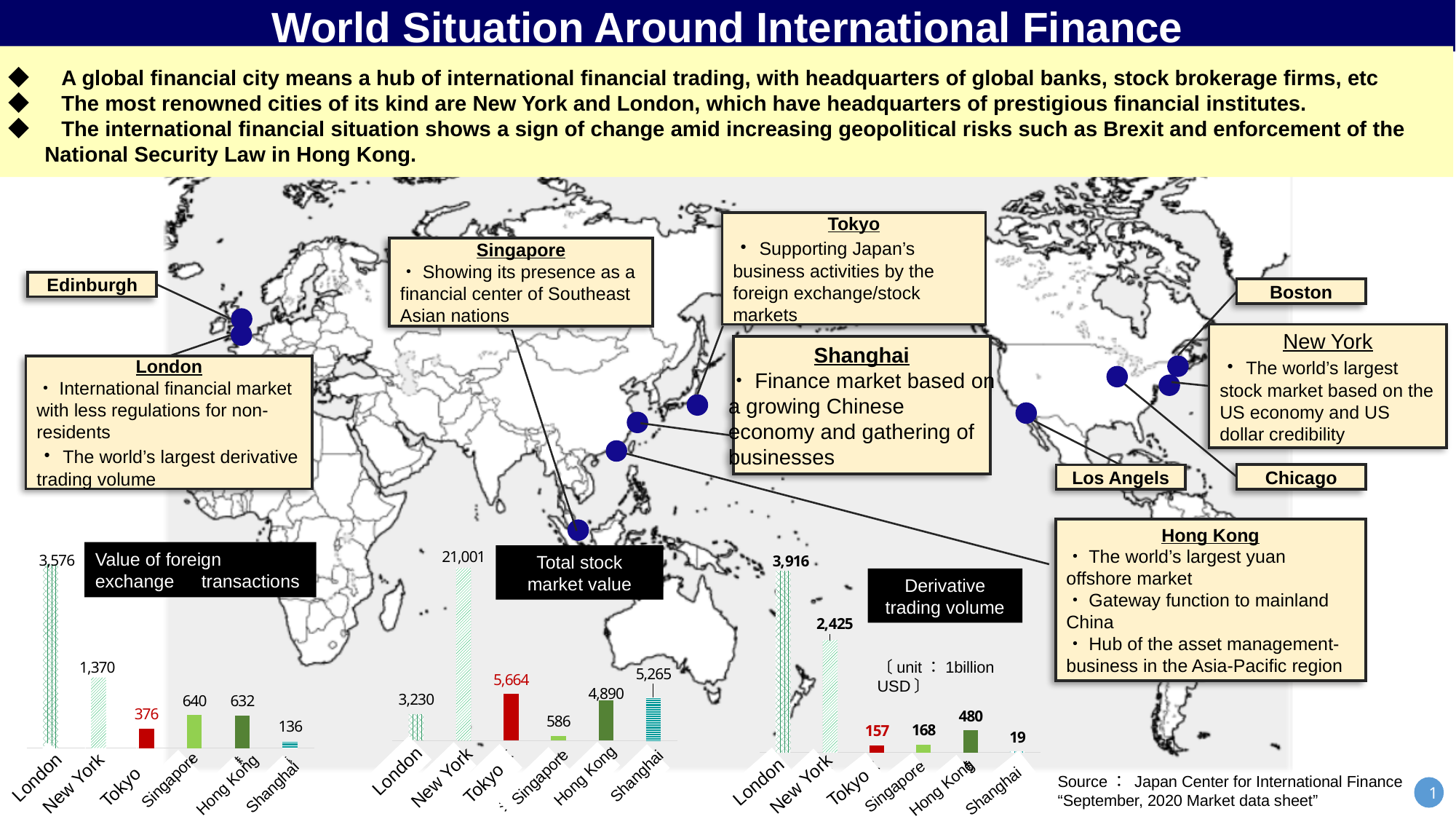
In the 'Derivative trading volume' chart, which city has the lowest value? Shanghai In the 'Total stock market value' chart, which city has the highest value? New York In the 'Derivative trading volume' chart, what is the value for Hong Kong? 480 In the 'Total stock market value' chart, which is larger, Tokyo or Shanghai? Tokyo In the 'Total stock market value' chart, what is the value for New York? 21,001 In the 'Value of foreign exchange transactions' chart, what is the difference between Singapore and Hong Kong? 8 What type of chart is the 'Value of foreign exchange transactions' chart? Bar chart In the 'Value of foreign exchange transactions' chart, which city has the lowest value? Shanghai In the 'Total stock market value' chart, what is the difference between Tokyo and Hong Kong? 774 How many cities are shown in the 'Derivative trading volume' chart? 6 In the 'Derivative trading volume' chart, what is the difference between London and New York? 1,491 In the 'Value of foreign exchange transactions' chart, what is the value for London? 3,576